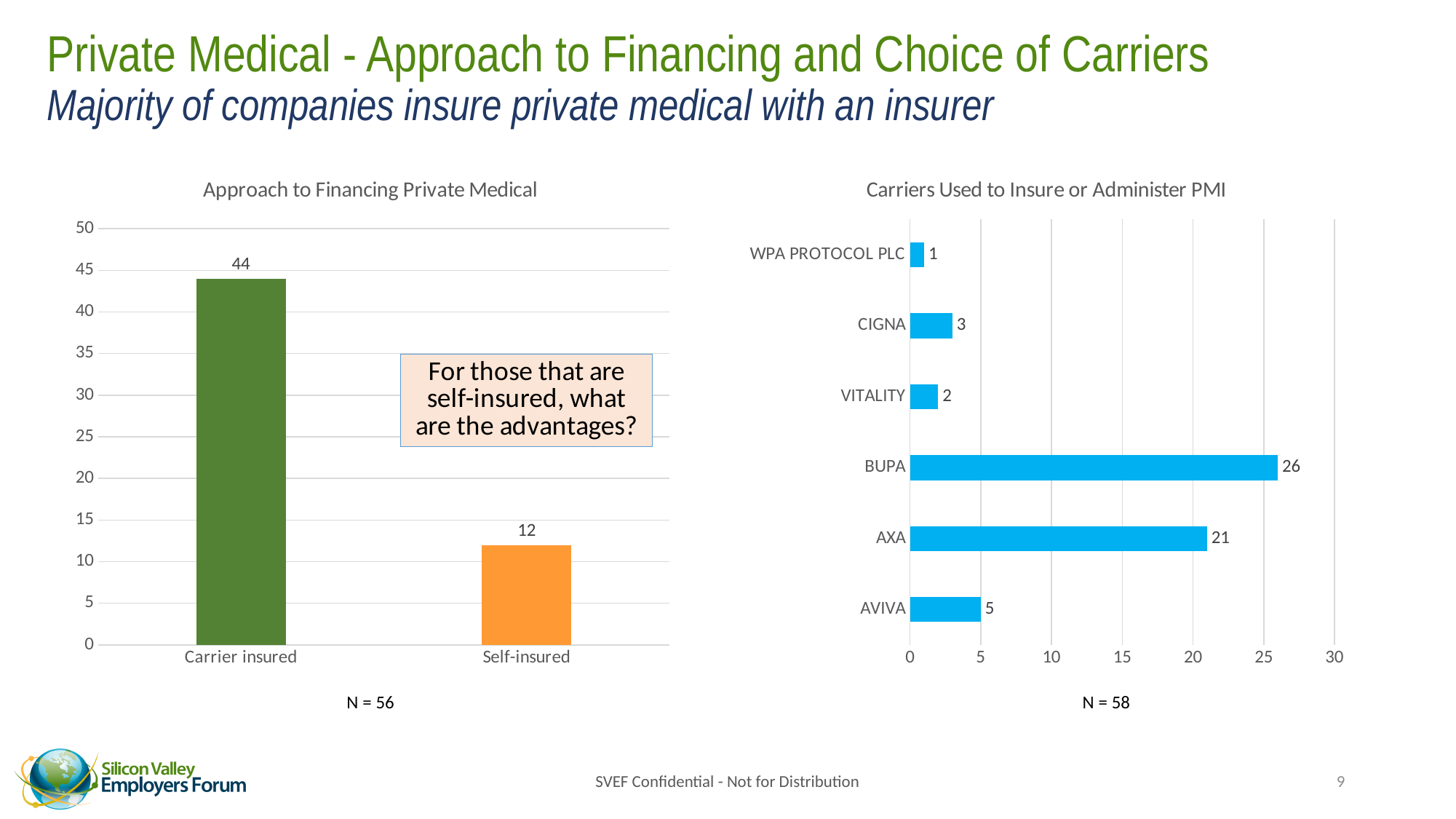
In the 'Carriers Used to Insure or Administer PMI' chart, what is the difference between BUPA and AXA? 5 In the 'Carriers Used to Insure or Administer PMI' chart, what is the value for BUPA? 26 In the 'Approach to Financing Private Medical' chart, how many categories are shown? 2 In the 'Carriers Used to Insure or Administer PMI' chart, what is the value for AXA? 21 In the 'Carriers Used to Insure or Administer PMI' chart, which carrier has the highest value? BUPA In the 'Carriers Used to Insure or Administer PMI' chart, which carrier has the lowest value? WPA PROTOCOL PLC In the 'Carriers Used to Insure or Administer PMI' chart, how many carriers are listed? 6 In the 'Approach to Financing Private Medical' chart, what is the difference between Carrier insured and Self-insured? 32 What kind of chart is 'Approach to Financing Private Medical'? Bar chart In the 'Carriers Used to Insure or Administer PMI' chart, which is larger, CIGNA or AVIVA? AVIVA In the 'Approach to Financing Private Medical' chart, what is the value for Self-insured? 12 In the 'Approach to Financing Private Medical' chart, what is the value for Carrier insured? 44